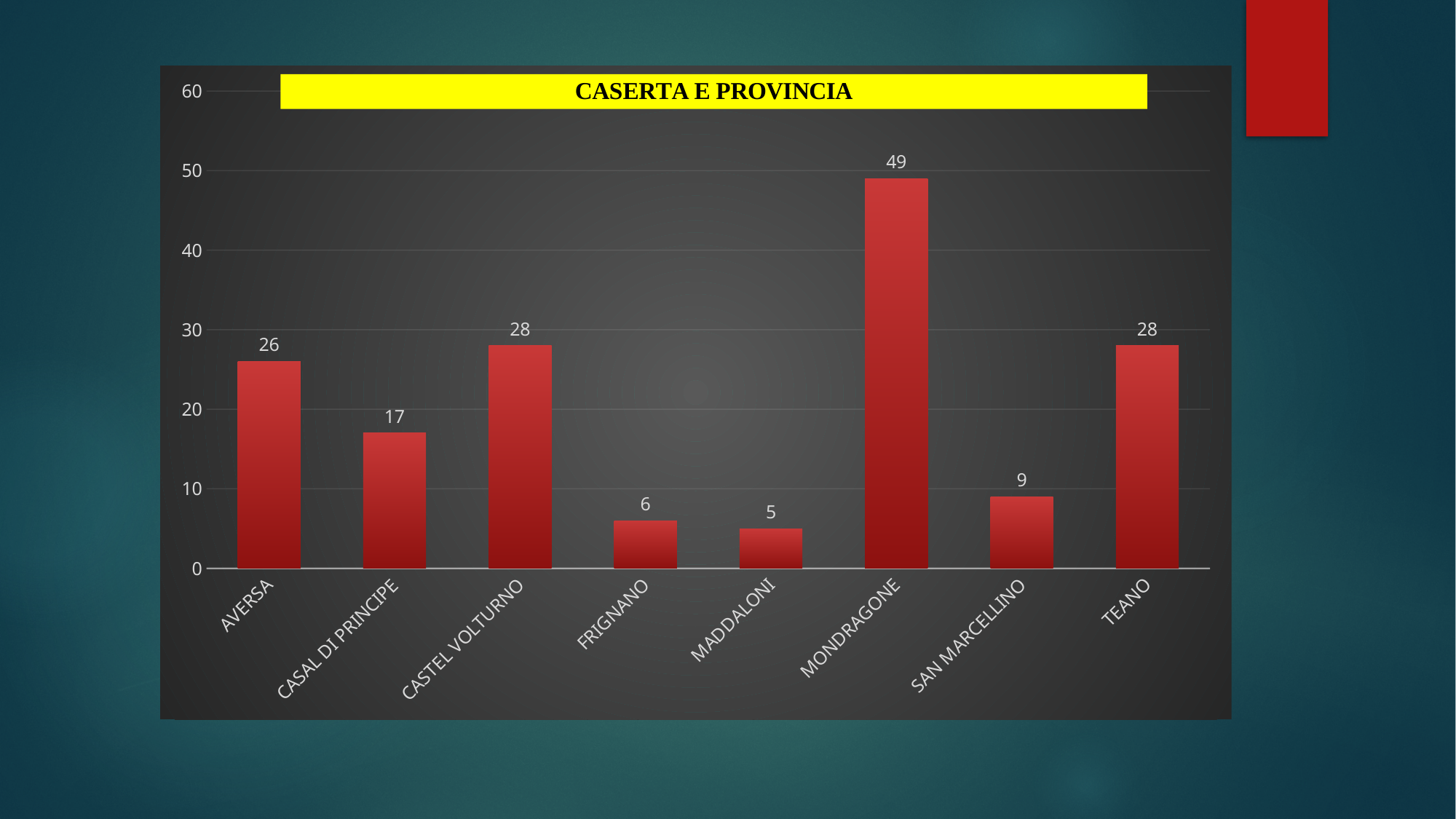
Which category has the lowest value? MADDALONI What is the difference between the values for MONDRAGONE and AVERSA? 23 What is the title of the chart? CASERTA E PROVINCIA What kind of chart is shown on the slide? bar chart Is the value for TEANO greater or less than 20? greater Which is larger, the value for AVERSA or the value for CASAL DI PRINCIPE? AVERSA What is the value for MONDRAGONE? 49 What is the value for MADDALONI? 5 What is the difference between the values for SAN MARCELLINO and FRIGNANO? 3 Which category has the highest value? MONDRAGONE What is the value for CASAL DI PRINCIPE? 17 How many categories are shown on the x axis? 8